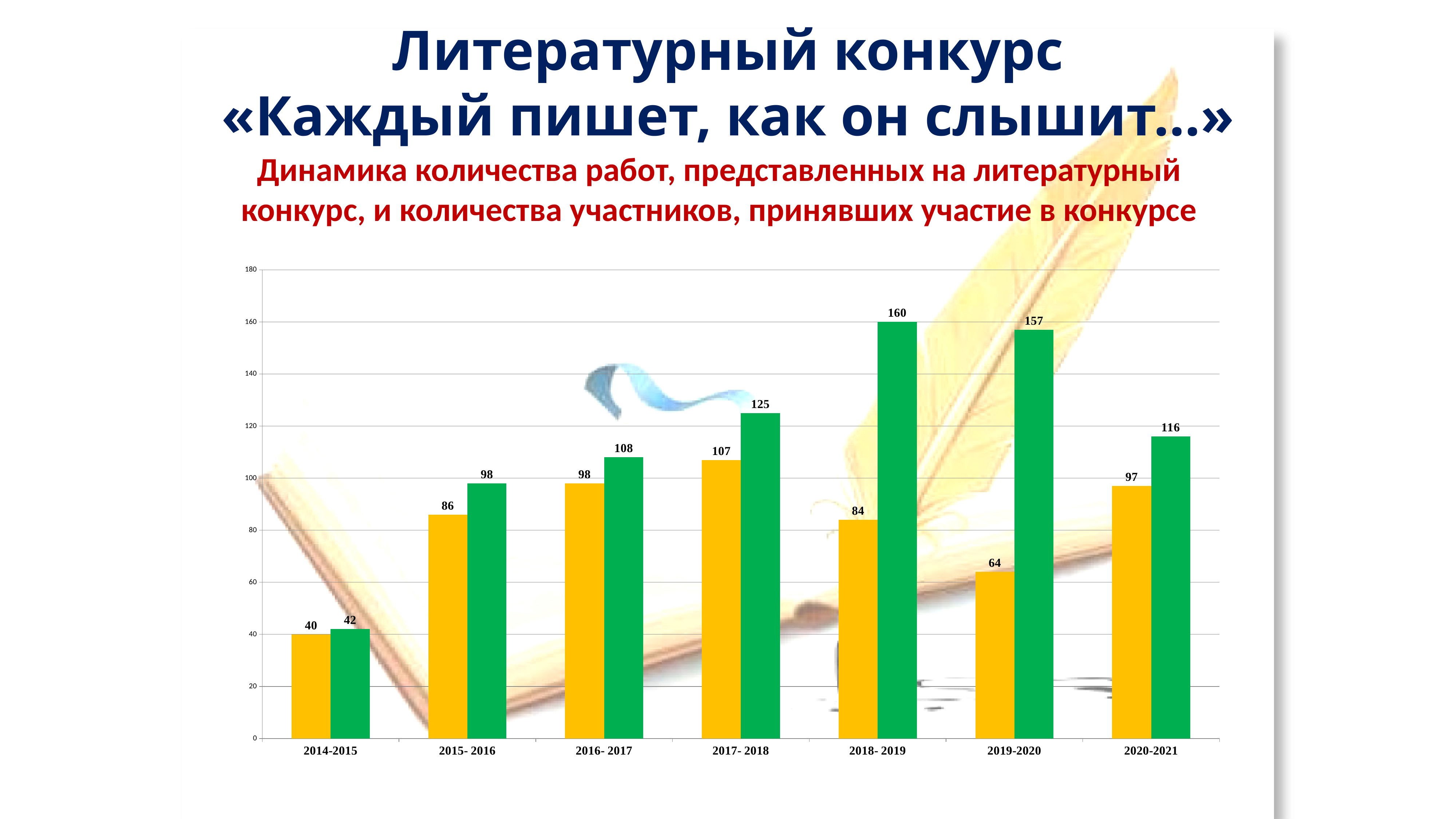
What two colours are used for the bars in the chart? yellow and green In which period is the green bar highest? 2018- 2019 What kind of chart is shown on the slide? bar chart Which is larger: the yellow bar for 2017- 2018 or the yellow bar for 2016- 2017? 2017- 2018 What is the value of the yellow bar for 2019-2020? 64 What is the value of the yellow bar for 2014-2015? 40 Does the green bar rise or fall from 2014-2015 to 2018- 2019? rise In which period is the yellow bar lowest? 2014-2015 What is the difference between the green bar and the yellow bar for 2018- 2019? 76 How many periods are shown on the x axis? 7 What is the value of the green bar for 2018- 2019? 160 What is the value of the green bar for 2020-2021? 116